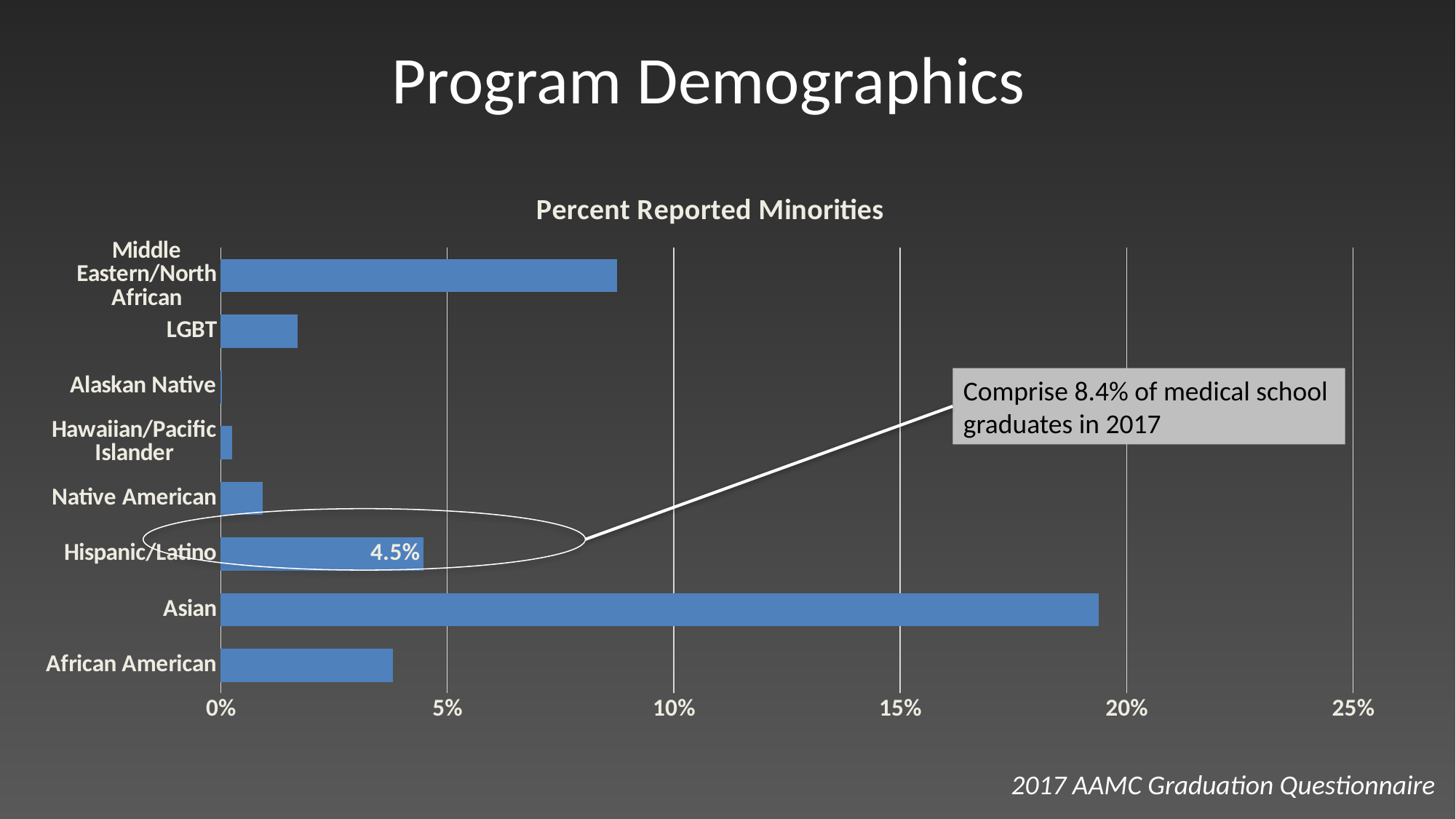
What is the title of the chart on the slide? Percent Reported Minorities What is the value for Hispanic/Latino in the Percent Reported Minorities chart? 4.5% Which is larger, the value for Middle Eastern/North African or the value for African American? Middle Eastern/North African Is the value for African American greater or less than 5%? less What kind of chart is shown on the slide? Bar chart Which category has the lowest value in the Percent Reported Minorities chart? Alaskan Native Which is larger, the value for Native American or the value for LGBT? LGBT Is the value for LGBT greater or less than 5%? less How many categories are shown in the Percent Reported Minorities chart? 8 Is the value for Middle Eastern/North African greater or less than 10%? less Which category has the highest value in the Percent Reported Minorities chart? Asian